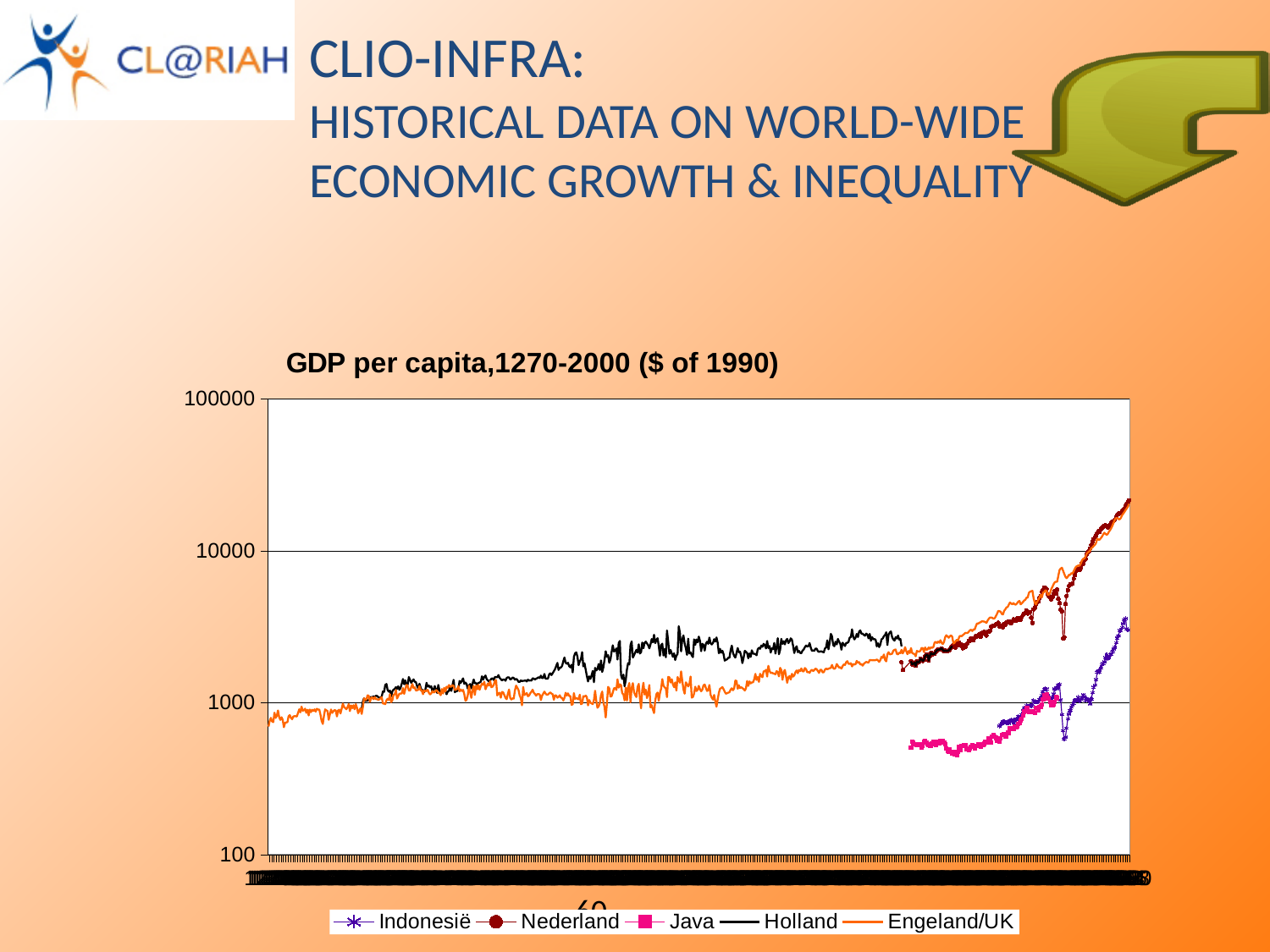
Does the Engeland/UK series rise or fall overall from left to right? rise What kind of chart is shown on the slide? line chart Which series is drawn in orange? Engeland/UK Is the value for Engeland/UK at the left end of the chart greater or less than 1000? less Is the value for Java at the start of its series greater or less than 1000? less Does the Nederland series rise or fall along the x axis? rise How many series does the legend list? 5 Is the value for Indonesië at the right end of the chart greater or less than 10000? less What is the title of the chart? GDP per capita,1270-2000 ($ of 1990) At the right end of the chart, which is larger: Nederland or Indonesië? Nederland